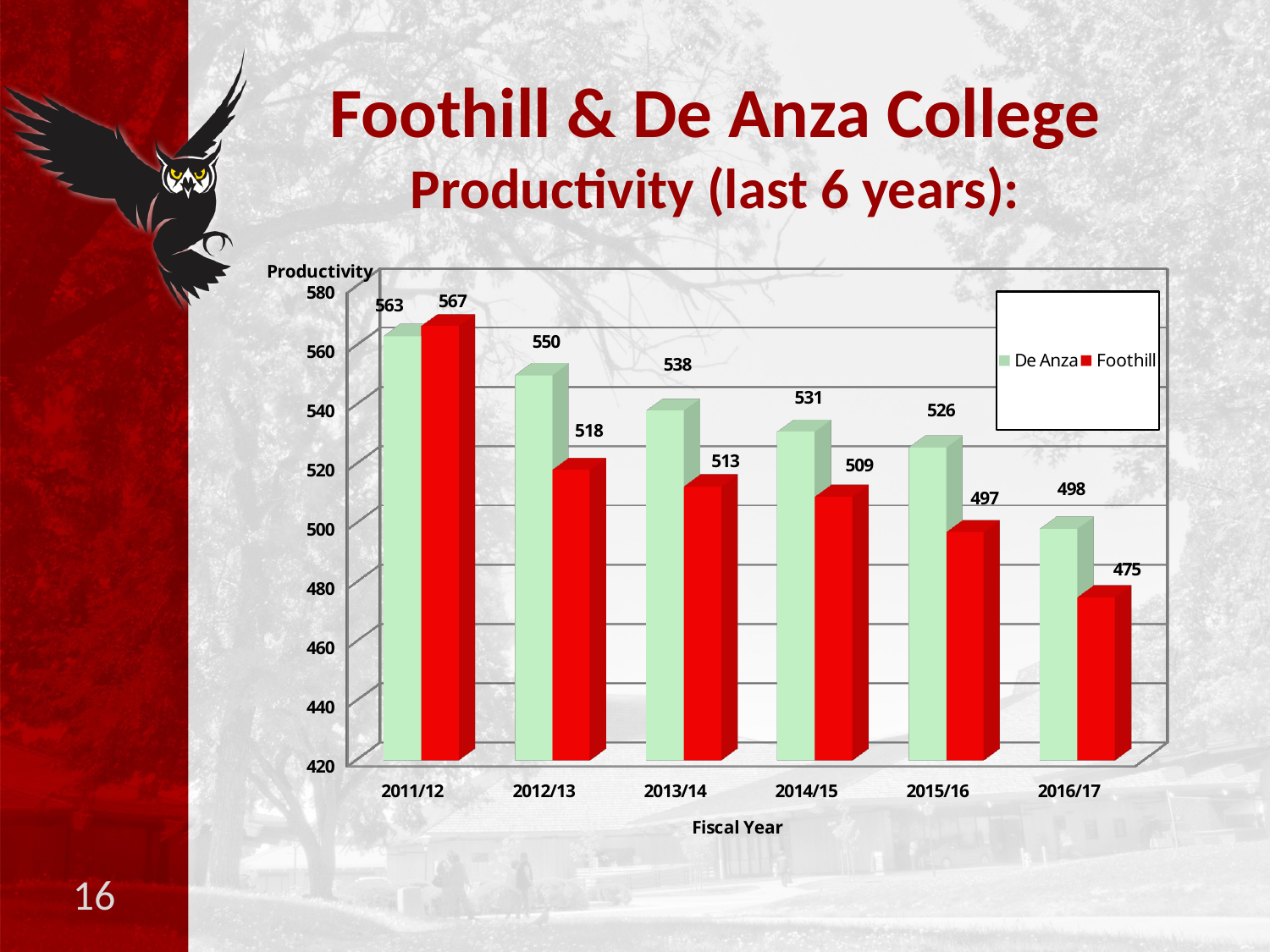
What is the De Anza productivity value for fiscal year 2013/14? 538 What kind of chart is shown on the slide? Bar chart Which college has the higher productivity in fiscal year 2011/12, De Anza or Foothill? Foothill In which fiscal year is De Anza's productivity highest? 2011/12 How many fiscal years are shown on the x axis? 6 What is the Foothill productivity value for fiscal year 2016/17? 475 How many series does the legend list? 2 Does Foothill's productivity rise or fall from 2011/12 to 2016/17? Fall What is the difference between De Anza and Foothill productivity in fiscal year 2015/16? 29 Which college has the higher productivity in fiscal year 2012/13, De Anza or Foothill? De Anza In which fiscal year is Foothill's productivity lowest? 2016/17 What is the Foothill productivity value for fiscal year 2011/12? 567